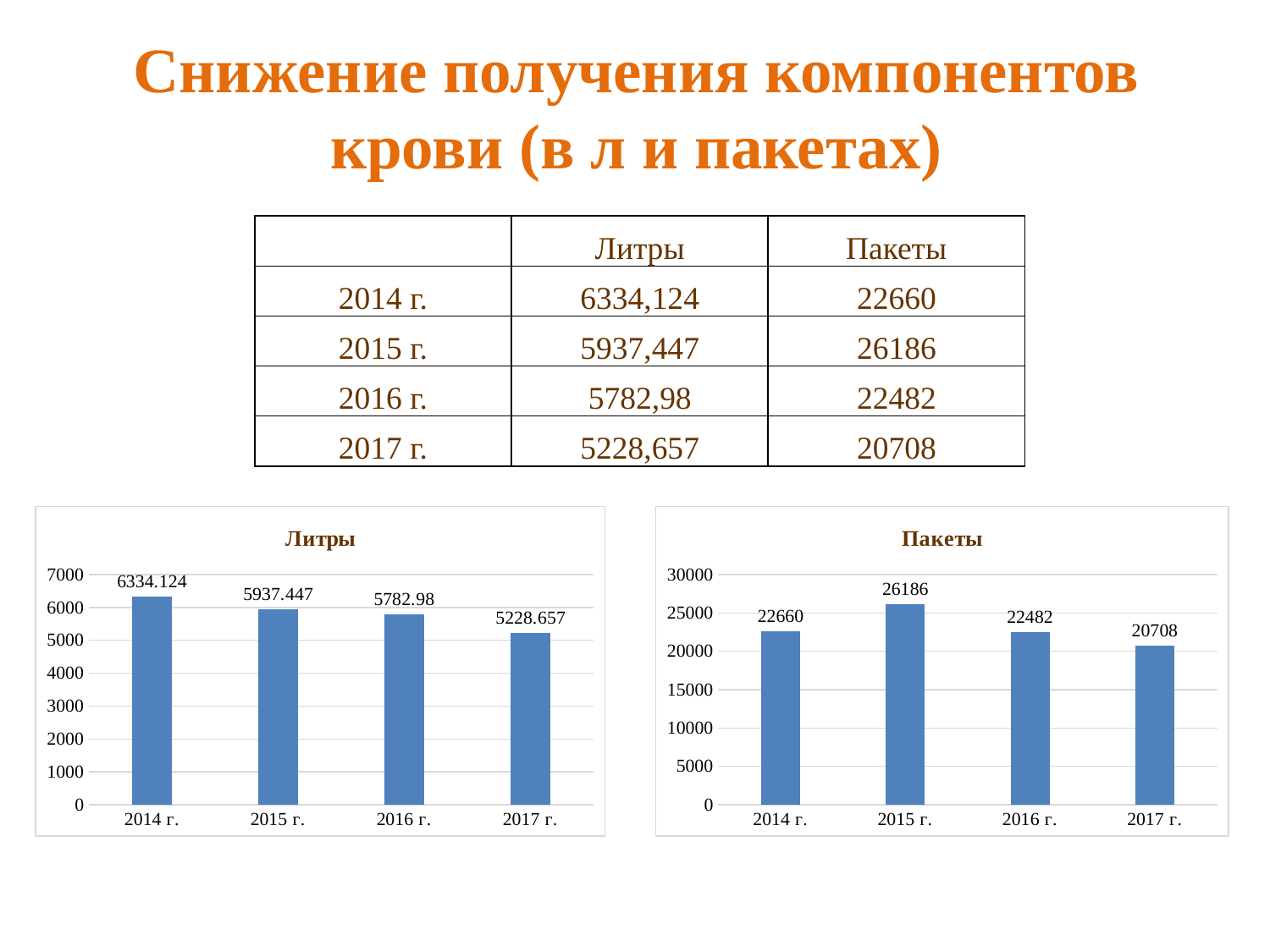
In the chart titled "Литры", what is the value for 2014 г.? 6334.124 How many years are shown in the chart titled "Литры"? 4 In the chart titled "Литры", do the values rise or fall from 2014 г. to 2017 г.? fall In the chart titled "Литры", which year has the lowest value? 2017 г. In the chart titled "Пакеты", what is the difference between the values for 2016 г. and 2017 г.? 1774 What kind of chart is the chart titled "Пакеты"? bar chart In the chart titled "Пакеты", is the value for 2017 г. greater or less than 25000? less In the chart titled "Пакеты", what is the value for 2015 г.? 26186 In the chart titled "Литры", what is the value for 2017 г.? 5228.657 In the chart titled "Пакеты", which year has the highest value? 2015 г. In the chart titled "Пакеты", what is the difference between the values for 2015 г. and 2014 г.? 3526 In the chart titled "Литры", which is larger, the value for 2015 г. or the value for 2016 г.? 2015 г.